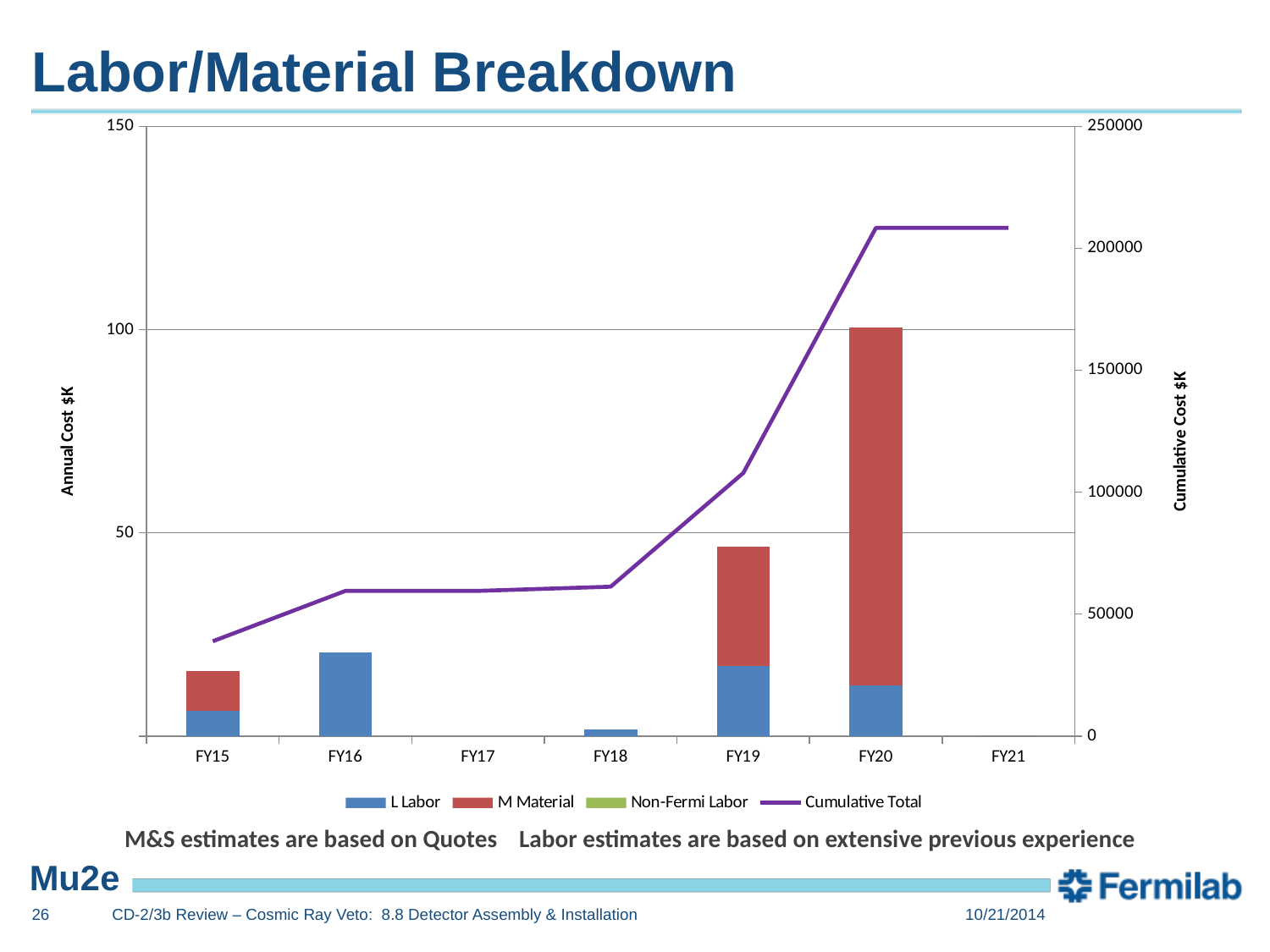
Which has a taller annual cost bar, FY19 or FY16? FY19 Is the Cumulative Total for FY20 greater or less than 200000? greater Does the Cumulative Total line rise or fall from FY15 to FY20? rise Is the total annual cost bar for FY19 greater or less than 50? less How many series does the legend list? 4 Is the total annual cost bar for FY20 greater or less than 50? greater What is the title of the slide containing the chart? Labor/Material Breakdown What kind of chart is shown on the slide? A combined bar and line chart How many fiscal years are shown on the x axis? 7 Which fiscal year has the tallest annual cost bar? FY20